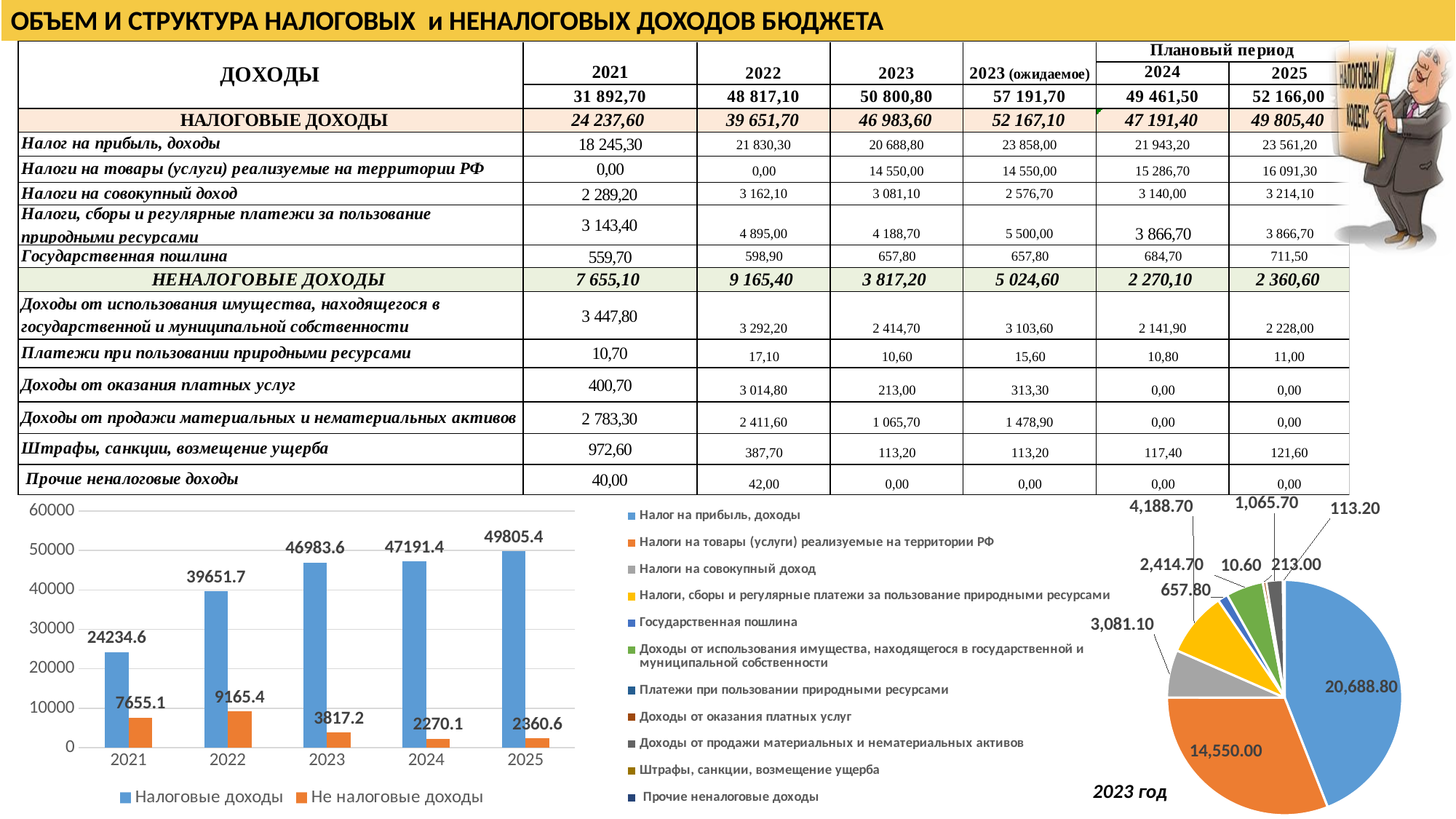
What kind of chart is shown at the bottom left of the slide? Bar chart In the bar chart at the bottom left, how many series does the legend list? 2 In the bar chart at the bottom left, what is the difference between Налоговые доходы and Не налоговые доходы in 2021? 16579.5 In the bar chart at the bottom left, which year has the highest value for Налоговые доходы? 2025 In the bar chart at the bottom left, do the values for Налоговые доходы rise or fall from 2021 to 2025? Rise In the bar chart at the bottom left, how many years are shown on the x axis? 5 In the bar chart at the bottom left, which year has the lowest value for Не налоговые доходы? 2024 In the bar chart at the bottom left, what is the value of Налоговые доходы for 2023? 46983.6 In the bar chart at the bottom left, which is larger: Не налоговые доходы in 2021 or in 2025? 2021 In the pie chart at the bottom right (2023 год), what is the value of the largest slice? 20,688.80 In the pie chart at the bottom right (2023 год), what is the value of the slice for Налоги на товары (услуги) реализуемые на территории РФ? 14,550.00 In the bar chart at the bottom left, what is the value of Не налоговые доходы for 2022? 9165.4